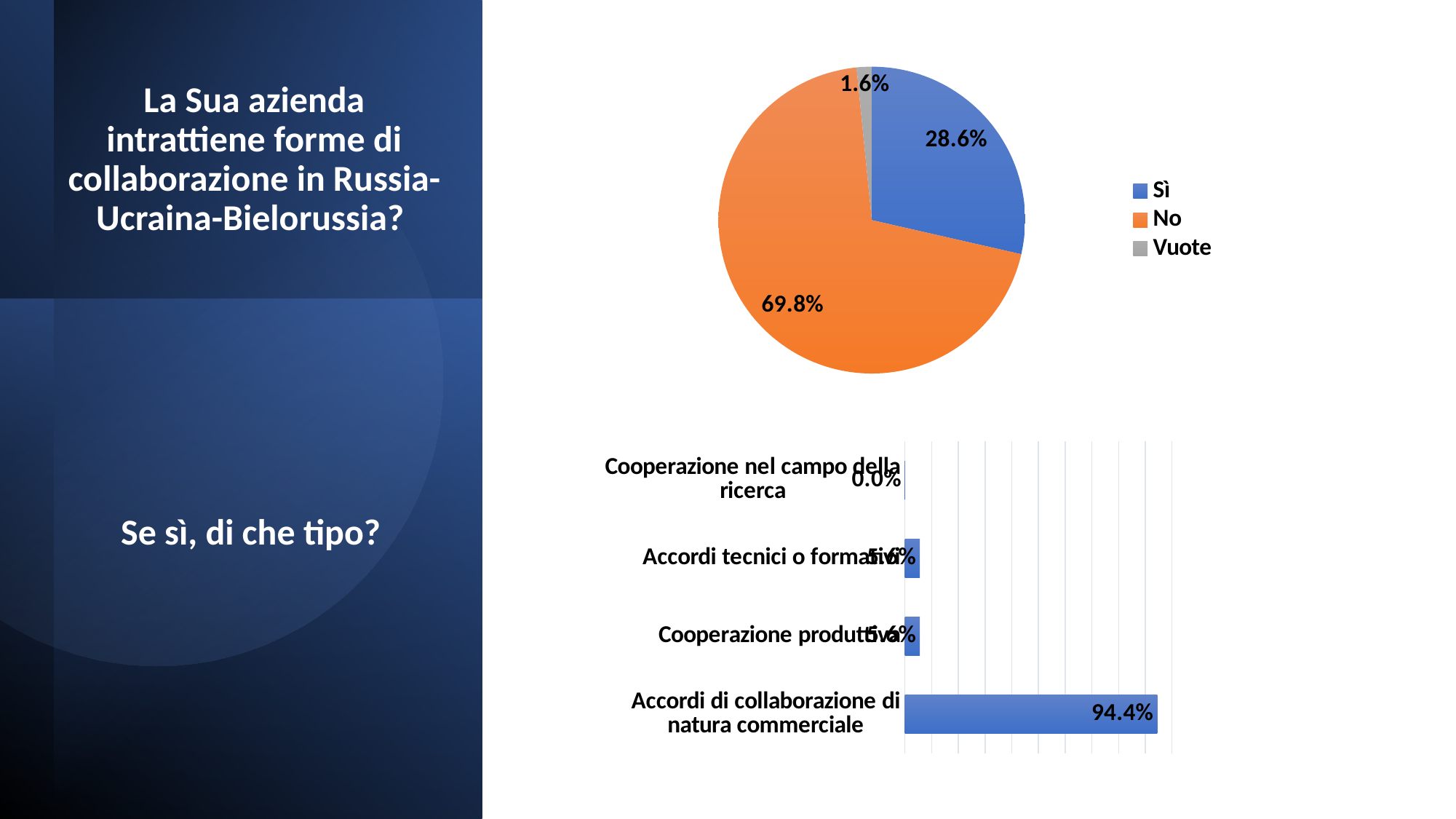
In the pie chart at the top of the slide, which category has the largest slice? No In the pie chart at the top of the slide, what is the difference in percentage points between "No" and "Sì"? 41.2 In the pie chart at the top of the slide, what percentage of respondents answered "Sì"? 28.6% In the bar chart at the bottom of the slide, how many categories are shown? 4 In the bar chart at the bottom of the slide, what is the value for "Accordi di collaborazione di natura commerciale"? 94.4% In the pie chart at the top of the slide, what share is labelled for "Vuote"? 1.6% In the pie chart at the top of the slide, how many entries does the legend list? 3 In the bar chart at the bottom of the slide, which category has the highest value? Accordi di collaborazione di natura commerciale In the bar chart at the bottom of the slide, what is the value for "Cooperazione nel campo della ricerca"? 0.0% In the pie chart at the top of the slide, which category has the smallest slice? Vuote What kind of chart is shown at the bottom of the slide? Bar chart In the pie chart at the top of the slide, what percentage of respondents answered "No"? 69.8%